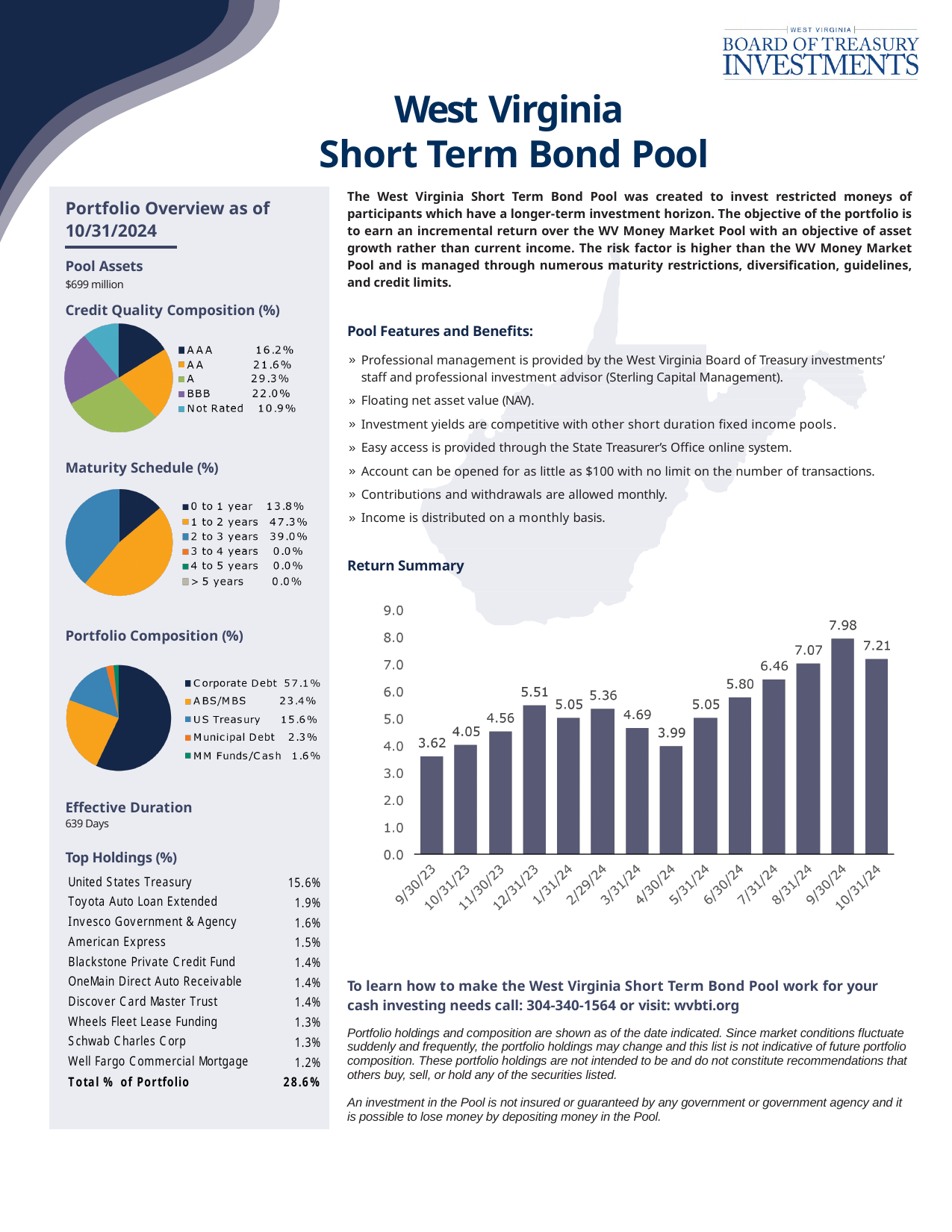
In the Return Summary chart, what is the value for 9/30/24? 7.98 In the Return Summary chart, what is the difference between the values for 9/30/24 and 10/31/24? 0.77 In the Return Summary chart, which is larger, the value for 12/31/23 or the value for 2/29/24? 12/31/23 In the Return Summary chart, which date has the lowest value? 9/30/23 How many bars are plotted in the Return Summary chart? 14 In the Return Summary chart, do the values rise or fall from 6/30/24 to 9/30/24? Rise In the Maturity Schedule pie chart, which maturity bucket has the largest share? 1 to 2 years In the Credit Quality Composition pie chart, what share is rated A? 29.3% What kind of chart is the Return Summary chart? Bar chart In the Return Summary chart, which date has the highest value? 9/30/24 In the Return Summary chart, what is the value for 4/30/24? 3.99 In the Portfolio Composition pie chart, what share is ABS/MBS? 23.4%